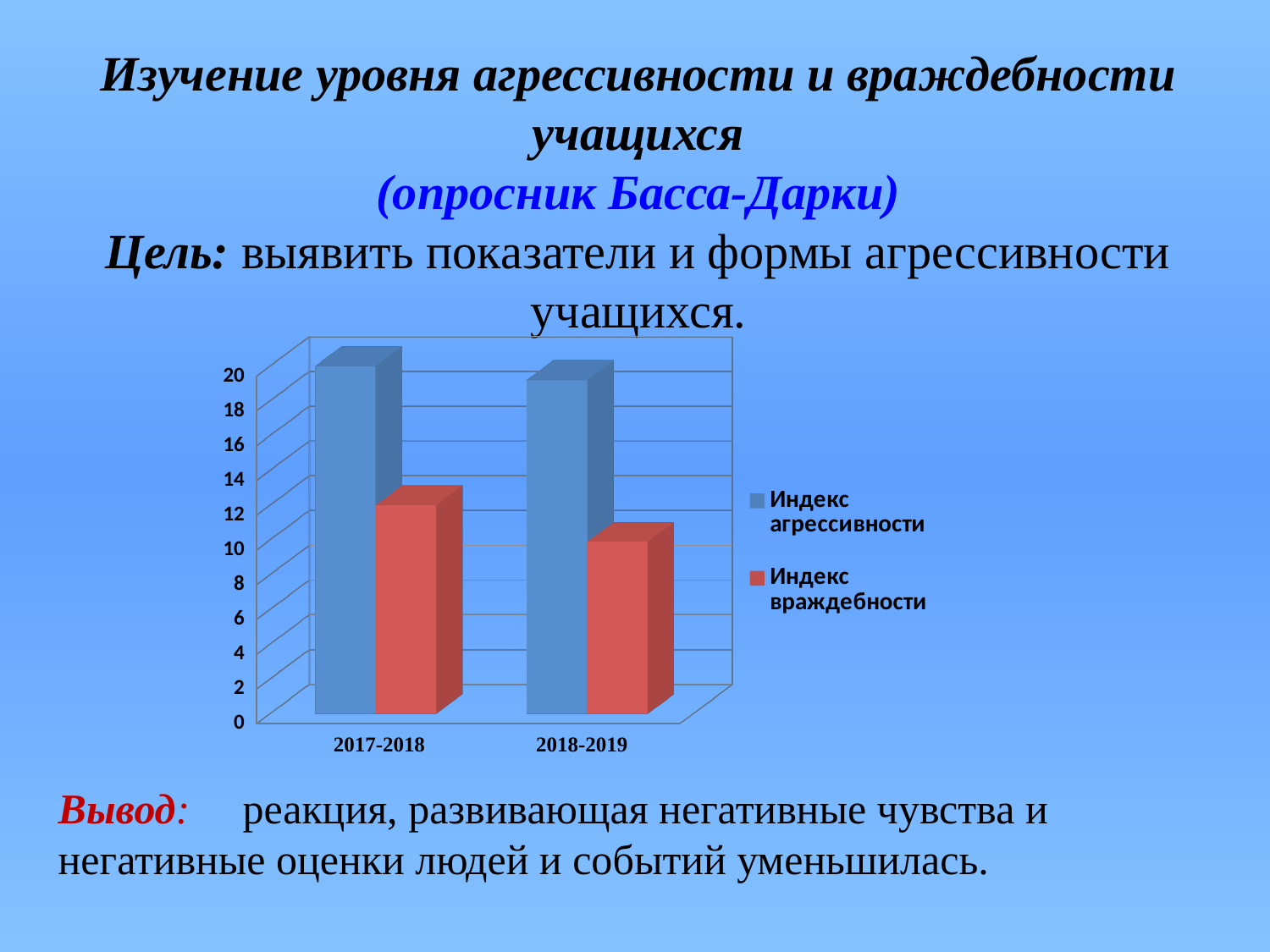
Is the value of Индекс враждебности for 2017-2018 greater or less than 10? greater How many series does the legend list? 2 Is the value of Индекс агрессивности for 2017-2018 greater or less than 18? greater In 2017-2018, which is larger: Индекс агрессивности or Индекс враждебности? Индекс агрессивности What colour are the bars for Индекс враждебности? red Which category has the higher value of Индекс враждебности? 2017-2018 Which two categories are shown on the x axis? 2017-2018 and 2018-2019 Does Индекс враждебности rise or fall from 2017-2018 to 2018-2019? fall Is the value of Индекс враждебности for 2018-2019 greater or less than 12? less How many categories are shown on the x axis? 2 What kind of chart is shown on the slide? bar chart